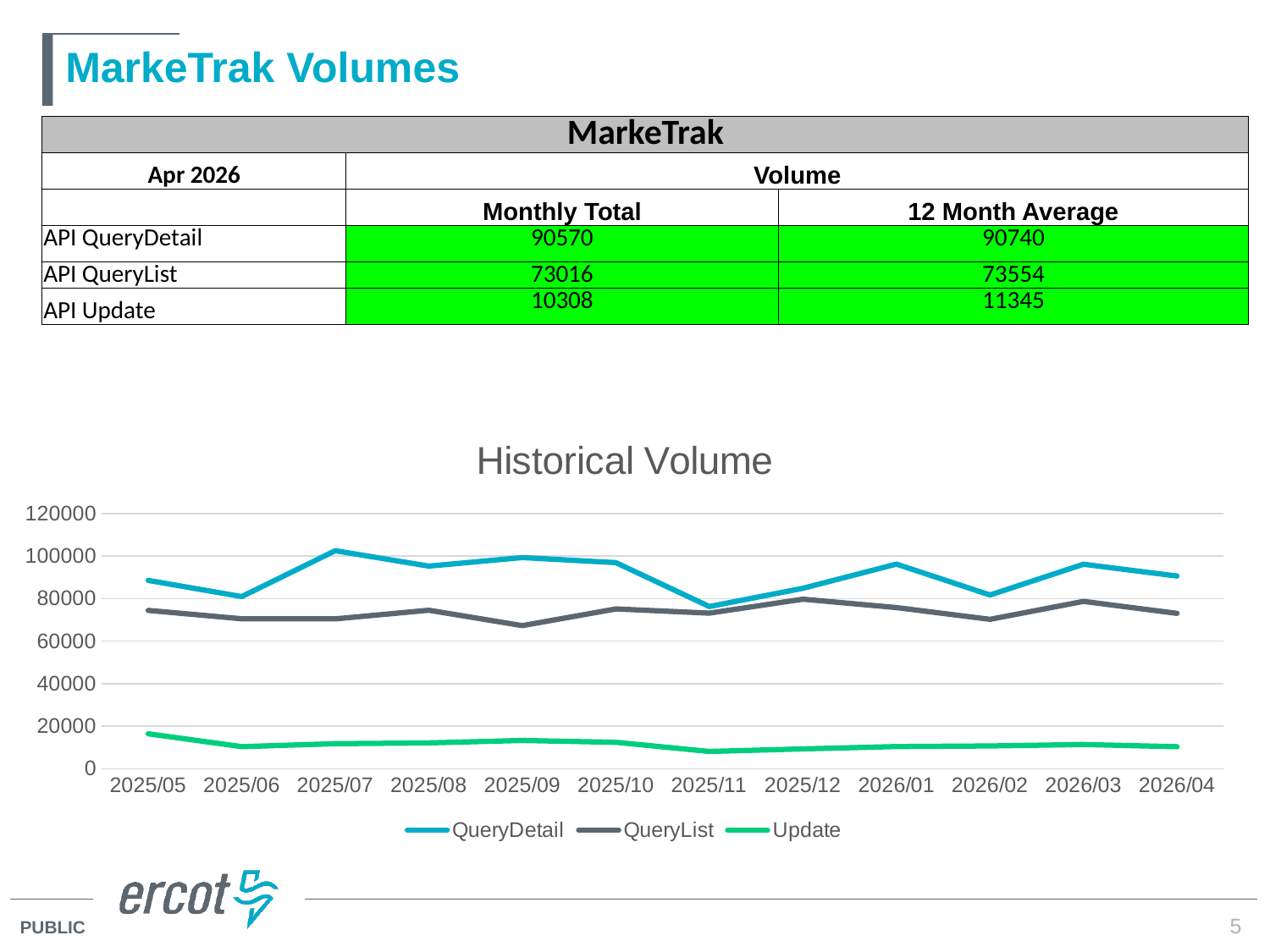
How many months are plotted along the x axis of the Historical Volume chart? 12 What is the title of the line chart on the slide? Historical Volume What kind of chart is the Historical Volume chart? line chart Which series has the lowest values throughout the Historical Volume chart? Update In the Historical Volume chart, which is larger at 2025/07: QueryDetail or QueryList? QueryDetail In the Historical Volume chart, is the QueryList value for 2025/09 greater or less than 80000? less In the Historical Volume chart, is the QueryDetail value for 2025/06 greater or less than 100000? less In the Historical Volume chart, does the QueryDetail series rise or fall from 2025/06 to 2025/07? rise In the Historical Volume chart, is the Update value for 2025/05 greater or less than 20000? less How many series does the legend of the Historical Volume chart list? 3 Which series has the highest values throughout the Historical Volume chart? QueryDetail In the Historical Volume chart, in which month is the Update series at its highest? 2025/05